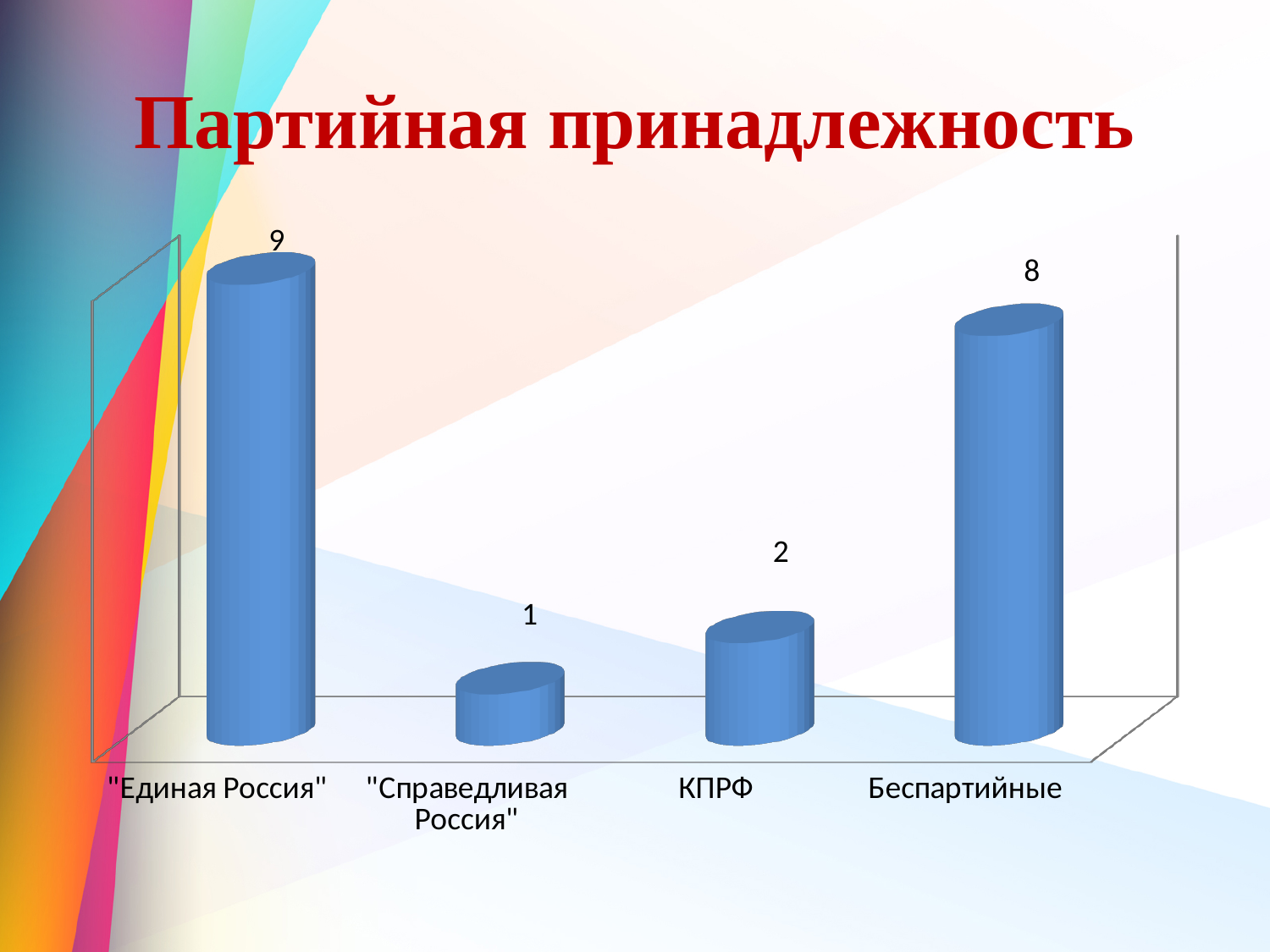
What is the value for КПРФ? 2 Which is larger, the value for КПРФ or the value for "Справедливая Россия"? КПРФ What is the difference between the values for Беспартийные and КПРФ? 6 How many categories are shown in the chart? 4 What kind of chart is shown on the slide? bar chart What is the title of the slide? Партийная принадлежность Which category has the lowest value? "Справедливая Россия" What is the difference between the values for "Единая Россия" and Беспартийные? 1 Which category has the highest value? "Единая Россия" What is the value for "Справедливая Россия"? 1 What is the value for "Единая Россия"? 9 What is the value for Беспартийные? 8